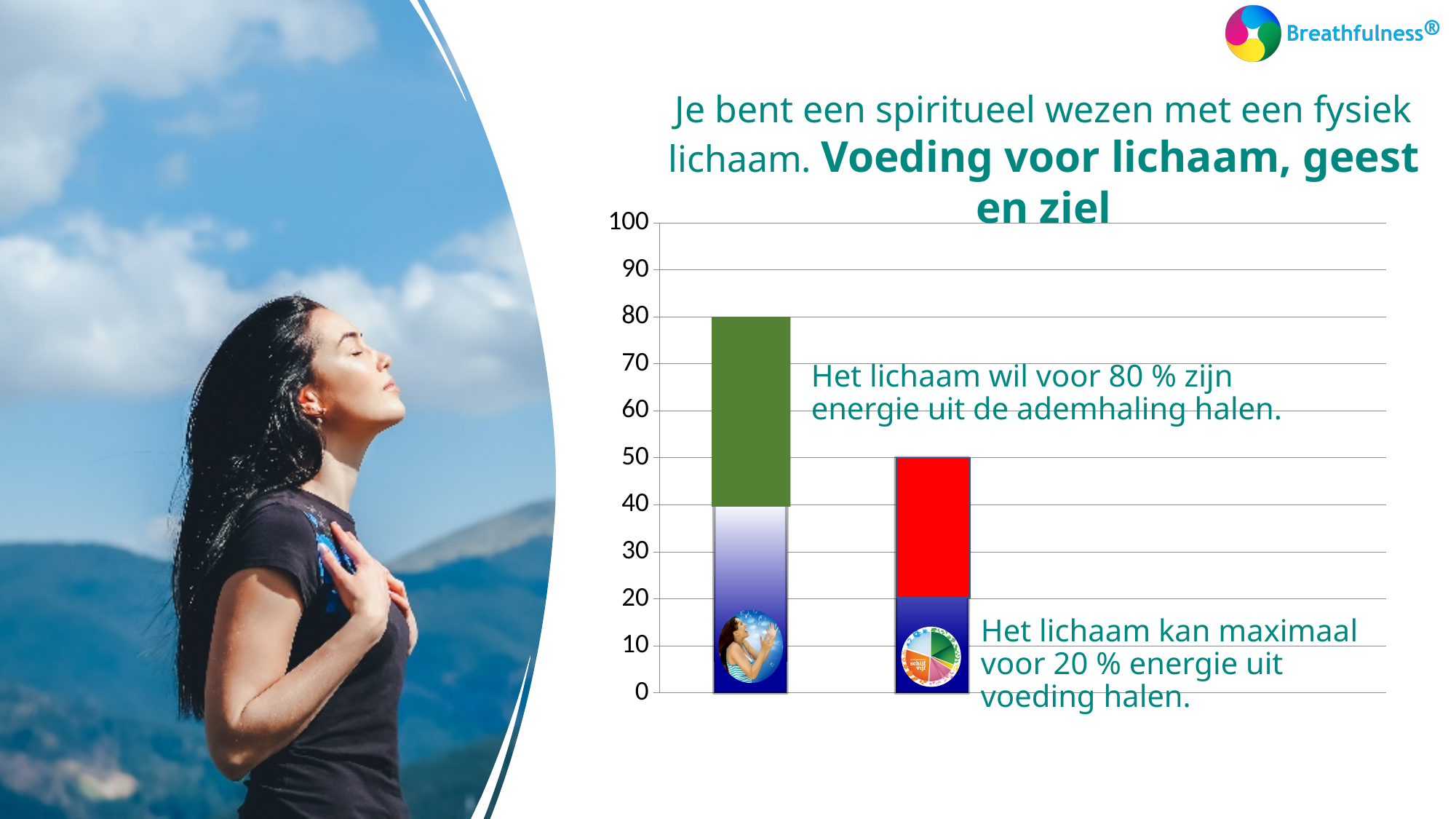
What is the difference between the top of the left bar and the top of the right bar? 30 What colour is the top segment of the right bar? red What is the highest value shown on the vertical axis? 100 What kind of chart is shown on the slide? bar chart Which bar reaches higher, the left bar or the right bar? the left bar According to the text next to the chart, what percentage of its energy does the body want to get from breathing (ademhaling)? 80 % Is the top of the right bar greater or less than 60? less At what value on the vertical axis does the green segment of the left bar begin? 40 At what value on the vertical axis does the top of the left bar end? 80 At what value on the vertical axis does the red segment of the right bar begin? 20 How many bars are plotted in the chart? 2 At what value on the vertical axis does the top of the right bar end? 50